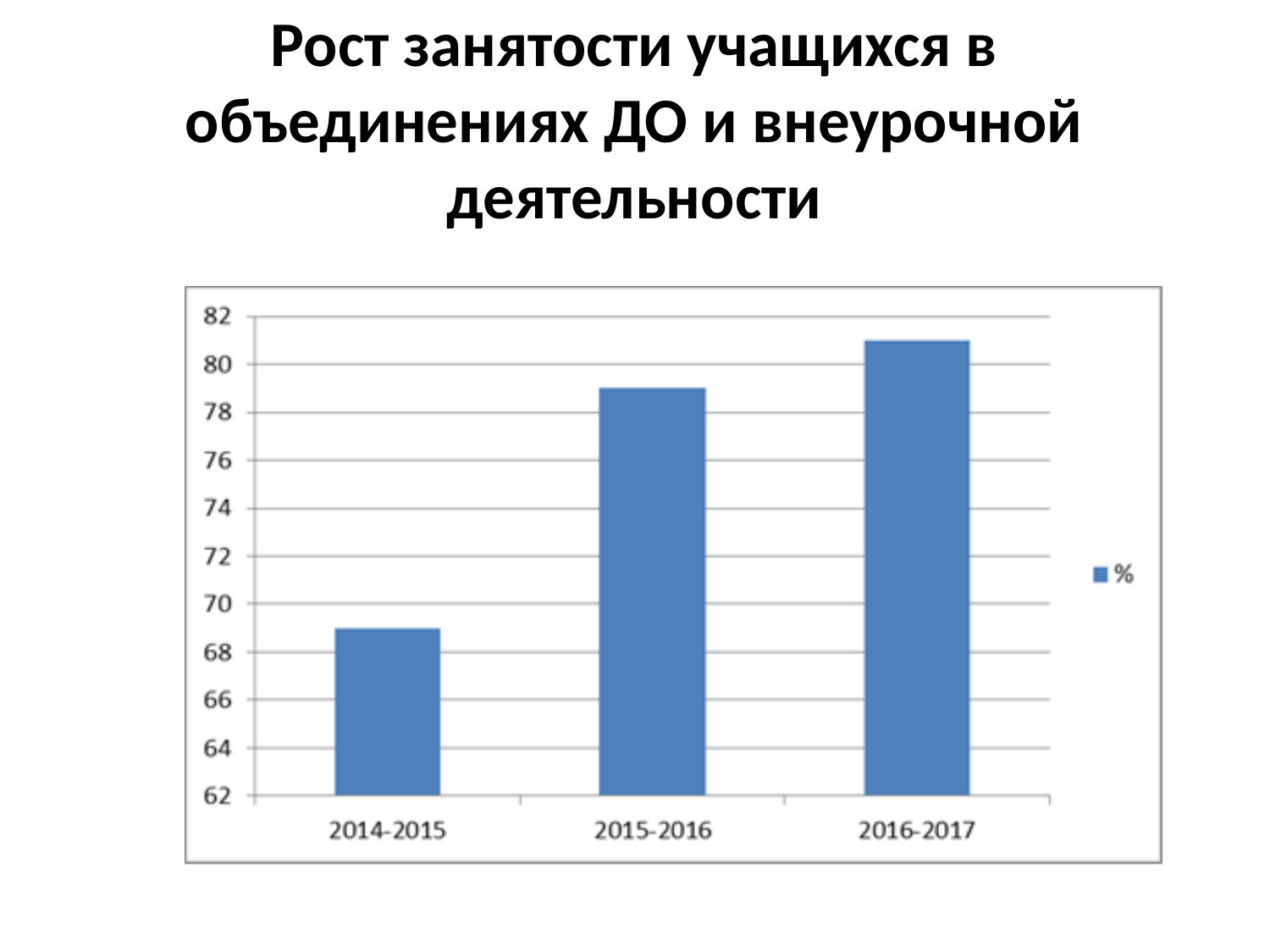
Is the value for 2016-2017 greater or less than 80? greater What is the legend entry for the series? % What kind of chart is shown on the slide? bar chart Which school year has the lowest value? 2014-2015 How many series does the legend list? 1 How many categories (school years) are shown on the x axis? 3 Is the value for 2015-2016 greater or less than 78? greater Which school year has the highest value? 2016-2017 Is the value for 2014-2015 greater or less than 70? less What is the title of the slide? Рост занятости учащихся в объединениях ДО и внеурочной деятельности Do the values rise or fall from 2014-2015 to 2016-2017? rise Which is larger, the value for 2014-2015 or the value for 2015-2016? 2015-2016